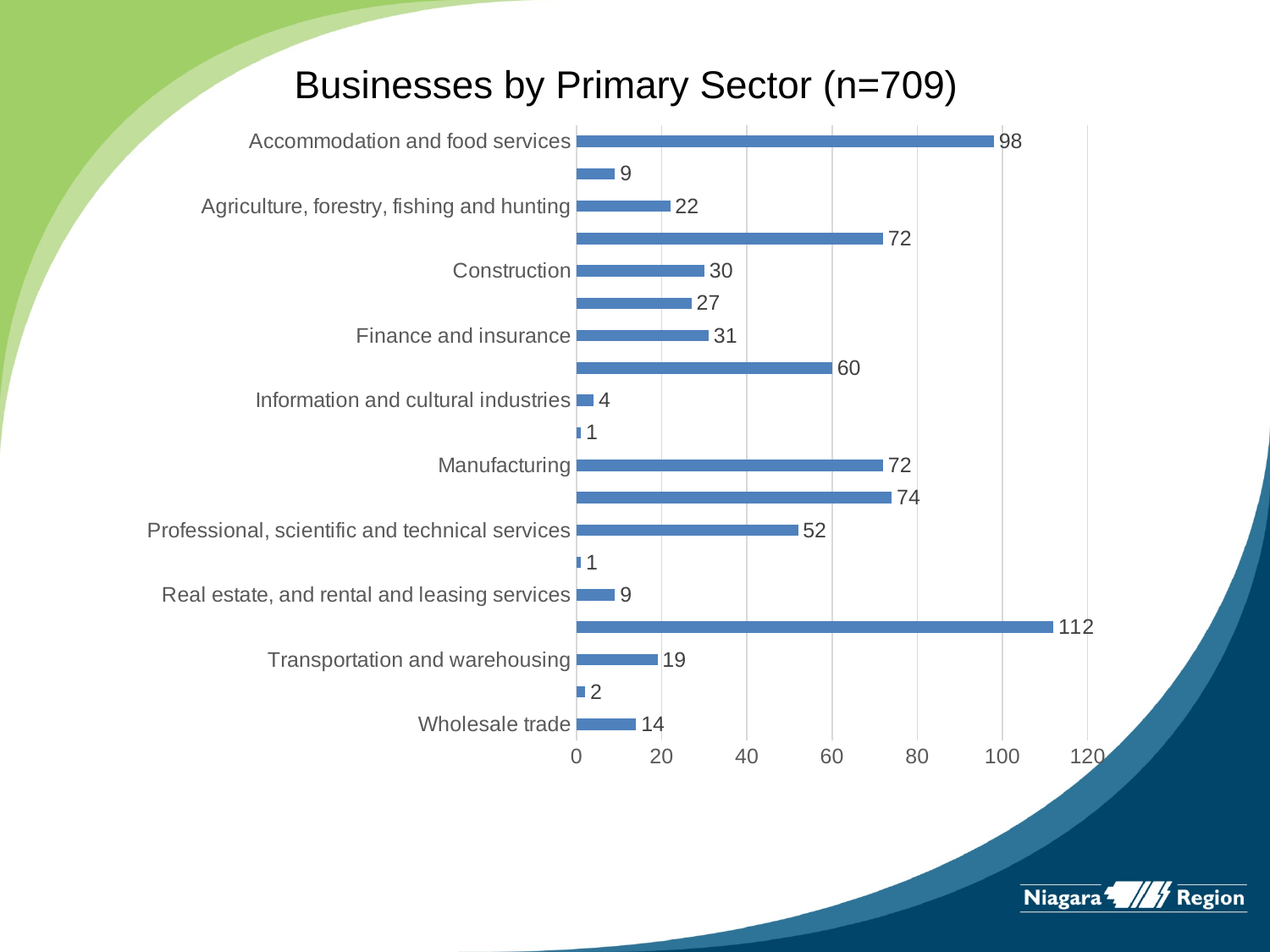
Which is larger, the value for Finance and insurance or the value for Real estate, and rental and leasing services? Finance and insurance What is the value for Information and cultural industries? 4 What is the value for Construction? 30 What is the title of the chart? Businesses by Primary Sector (n=709) What is the difference between the values for Accommodation and food services and Manufacturing? 26 What is the value for Accommodation and food services? 98 What is the value for Professional, scientific and technical services? 52 What is the value for Manufacturing? 72 What is the difference between the values for Agriculture, forestry, fishing and hunting and Transportation and warehousing? 3 How many bars are plotted in the chart? 19 What is the value for Wholesale trade? 14 What kind of chart is shown on the slide? Bar chart